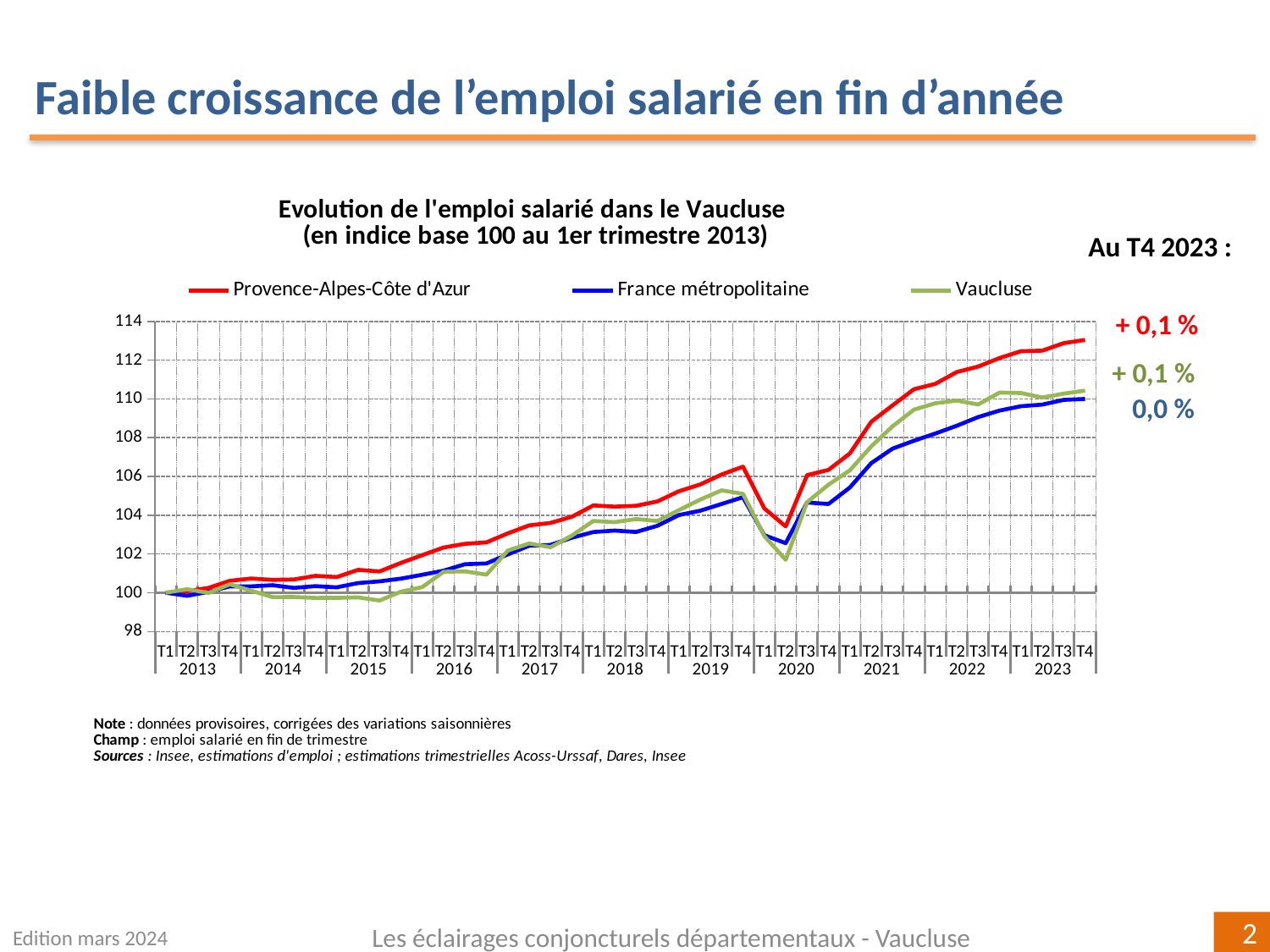
Which series has the lowest value at T2 2020? Vaucluse What is the index value of all three series at T1 2013? 100 At T4 2023, which is larger: Provence-Alpes-Côte d'Azur or France métropolitaine? Provence-Alpes-Côte d'Azur How many series does the legend list? 3 Is the value for Vaucluse at T2 2020 greater or less than 104? less How many years are labelled along the x axis? 11 Which colour is used for the Vaucluse series? green What kind of chart is shown on the slide? line chart Which series has the highest value at T4 2023? Provence-Alpes-Côte d'Azur What is the title of the chart? Evolution de l'emploi salarié dans le Vaucluse (en indice base 100 au 1er trimestre 2013) Overall, do the series rise or fall between 2013 and 2023? rise Is the value for Provence-Alpes-Côte d'Azur at T4 2023 greater or less than 112? greater